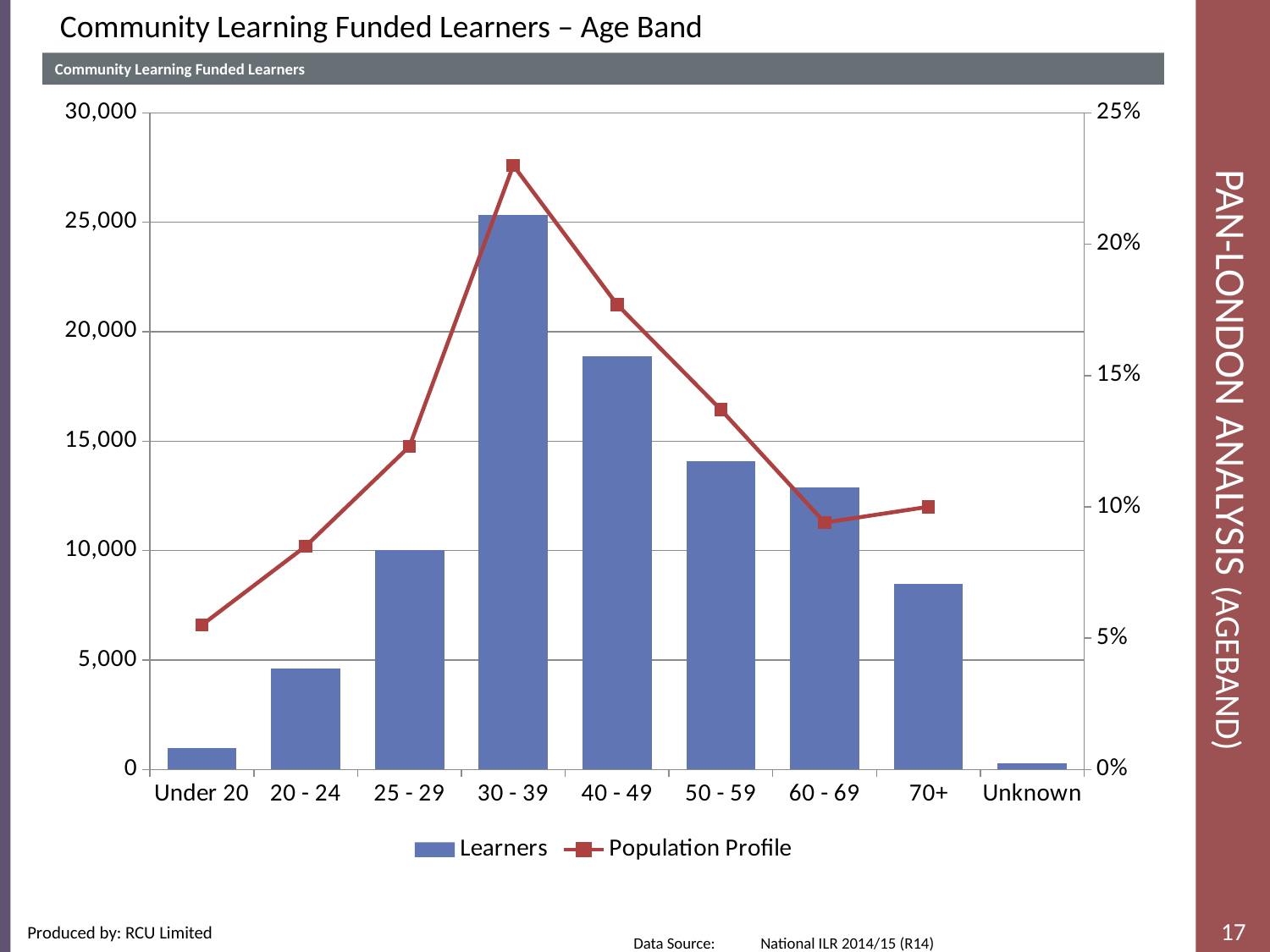
Is the number of Learners for 20 - 24 greater or less than 5,000? less How many series does the legend list? 2 Which age band has the lowest Population Profile value? Under 20 Which age band has the highest number of Learners? 30 - 39 Which age band has the lowest number of Learners? Unknown Is the Population Profile value for 40 - 49 greater or less than 15%? greater Is the number of Learners for 30 - 39 greater or less than 25,000? greater Do the Learners values rise or fall from 30 - 39 to 70+? fall How many age band categories are shown on the x axis? 9 Which has more Learners, 40 - 49 or 50 - 59? 40 - 49 Which age band has the highest Population Profile value? 30 - 39